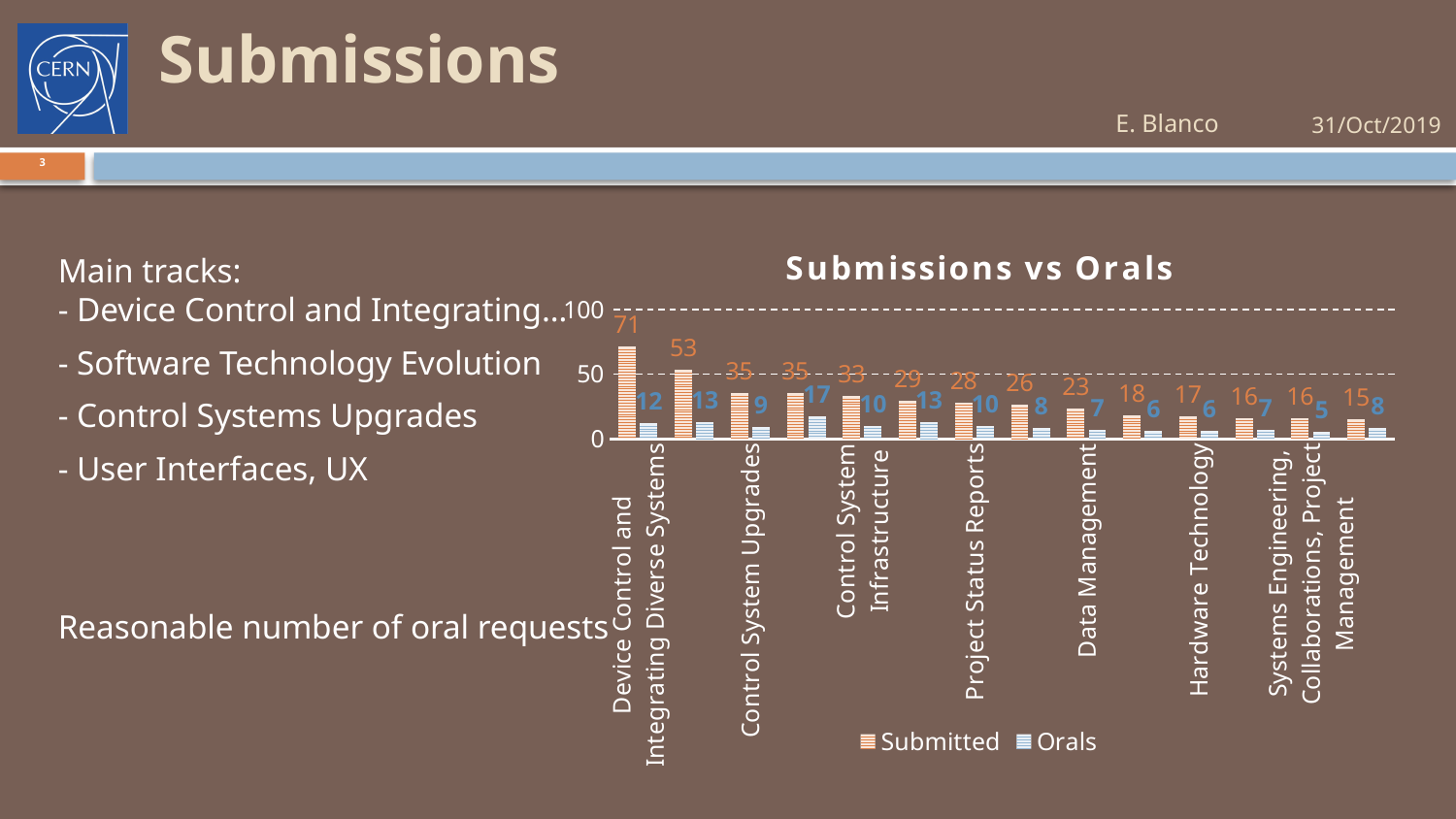
What is the Submitted value for Device Control and Integrating Diverse Systems? 71 Do the Submitted values rise or fall from left to right along the x axis? fall Is the Submitted value for Hardware Technology greater or less than 50? less What is the title of the chart? Submissions vs Orals What is the Orals value for Control System Upgrades? 9 How many series does the chart legend list? 2 What is the Submitted value for Data Management? 23 What is the difference between the Submitted and Orals values for Device Control and Integrating Diverse Systems? 59 Which has a larger Orals value, Project Status Reports or Data Management? Project Status Reports What type of chart is shown on the slide? bar chart What is the Orals value for Hardware Technology? 6 Which category has the highest Submitted value? Device Control and Integrating Diverse Systems